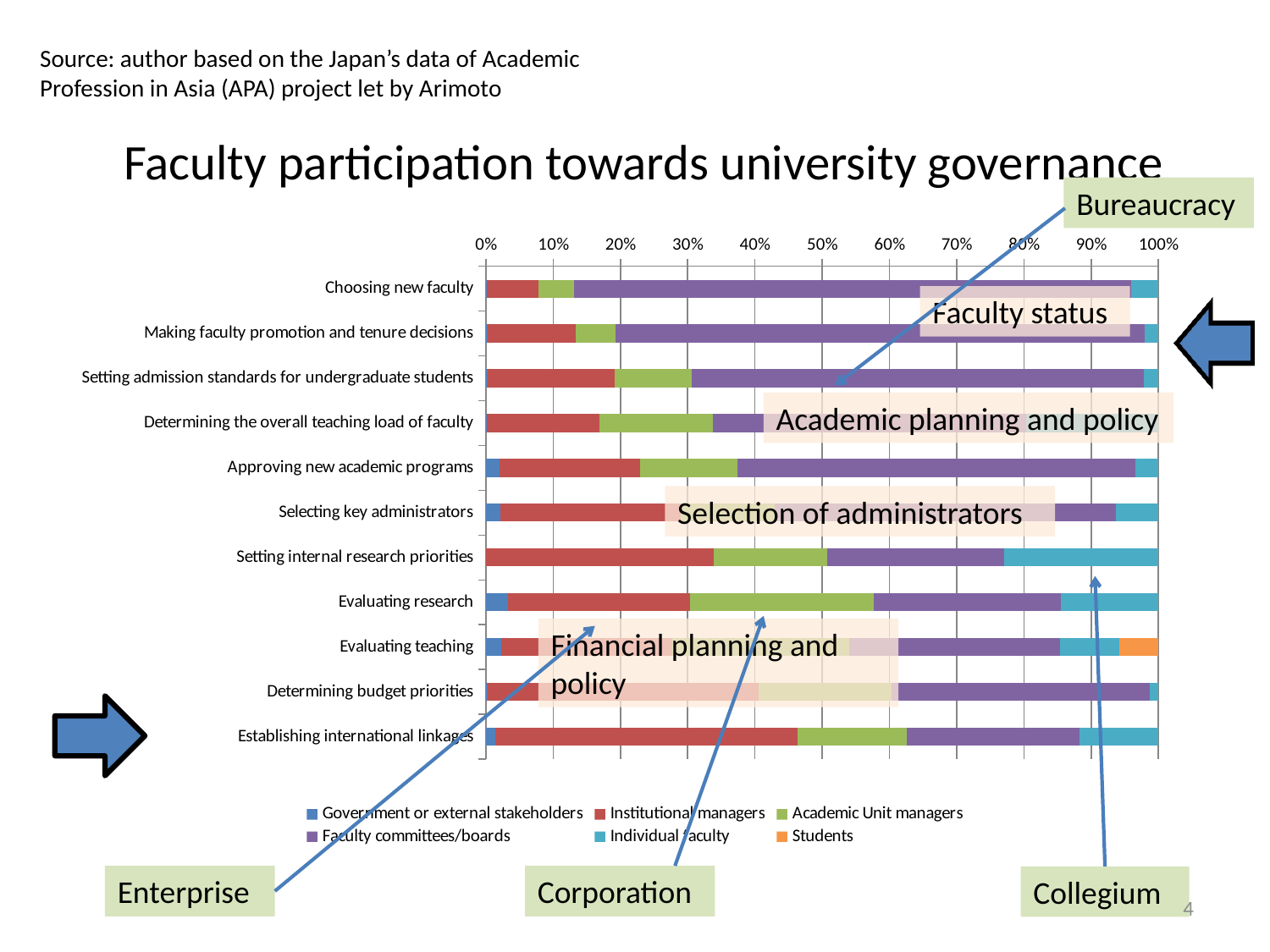
Is the Government or external stakeholders value for Evaluating research greater or less than 10%? less Is the Individual faculty value for Determining budget priorities greater or less than 10%? less Is the Institutional managers value for Setting internal research priorities greater or less than 30%? greater In which category does the Students series appear? Evaluating teaching Which has the larger Institutional managers value: Establishing international linkages or Choosing new faculty? Establishing international linkages What is the title of the chart? Faculty participation towards university governance What is the total of the stacked bar for Choosing new faculty? 100% How many categories are plotted on the vertical axis of the chart? 11 How many series does the chart's legend list? 6 What kind of chart is shown on the slide? Stacked horizontal bar chart